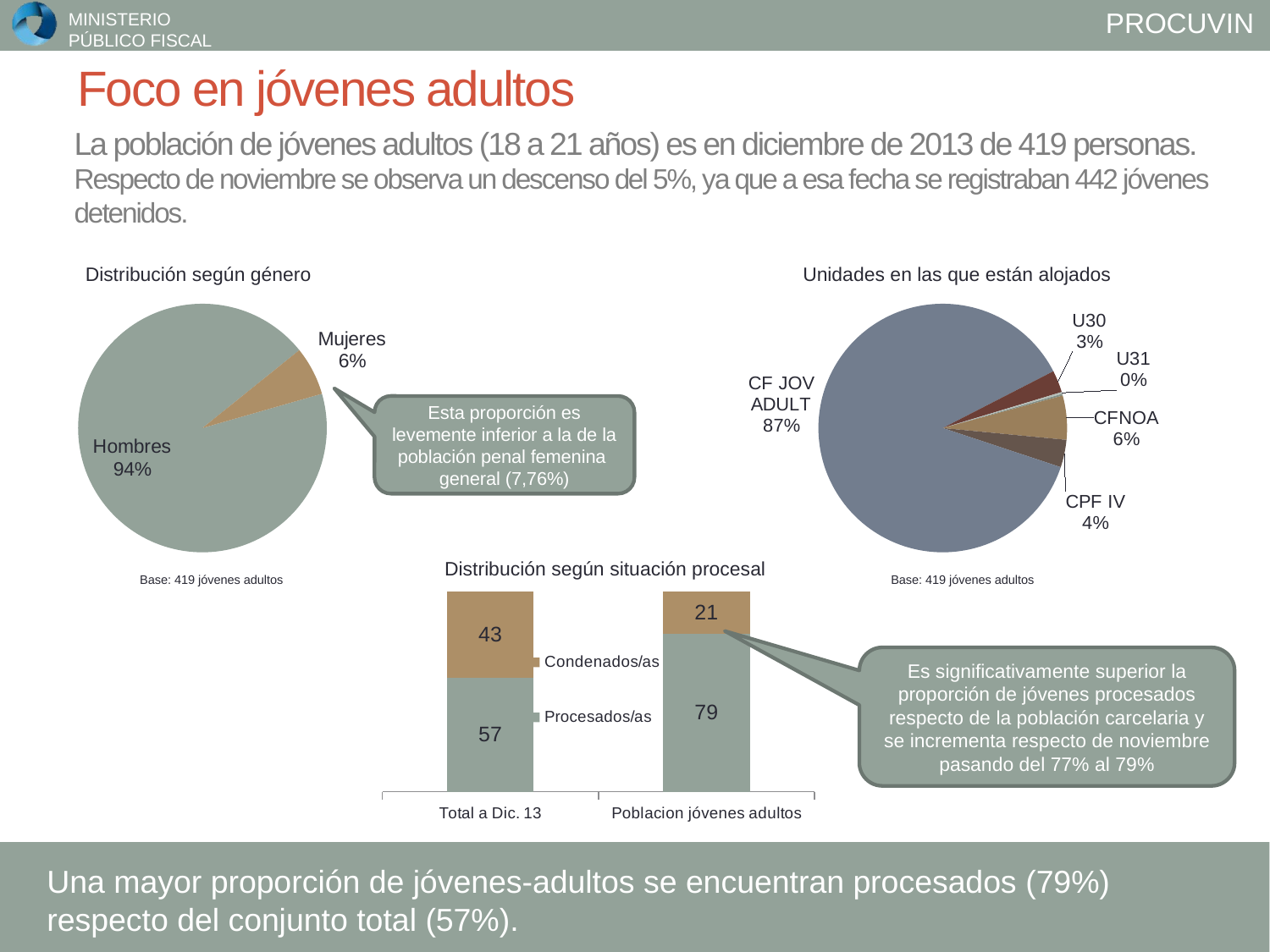
In the 'Distribución según situación procesal' chart, what is the Procesados/as value for Poblacion jóvenes adultos? 79 In the 'Distribución según situación procesal' chart, what is the Condenados/as value for Total a Dic. 13? 43 In the 'Distribución según género' chart, what is the value for Hombres? 94% In the 'Distribución según situación procesal' chart, what is the difference between the Procesados/as values for Poblacion jóvenes adultos and Total a Dic. 13? 22 In the 'Unidades en las que están alojados' chart, what is the value for CPF IV? 4% In the 'Unidades en las que están alojados' chart, what is the value for CFNOA? 6% How many categories are shown in the 'Unidades en las que están alojados' chart? 5 How many series does the legend of the 'Distribución según situación procesal' chart list? 2 In the 'Unidades en las que están alojados' chart, which unit has the largest share? CF JOV ADULT In the 'Unidades en las que están alojados' chart, which is larger, U30 or CFNOA? CFNOA What kind of chart is 'Distribución según género'? Pie chart In the 'Distribución según género' chart, what share of the pie is Mujeres? 6%